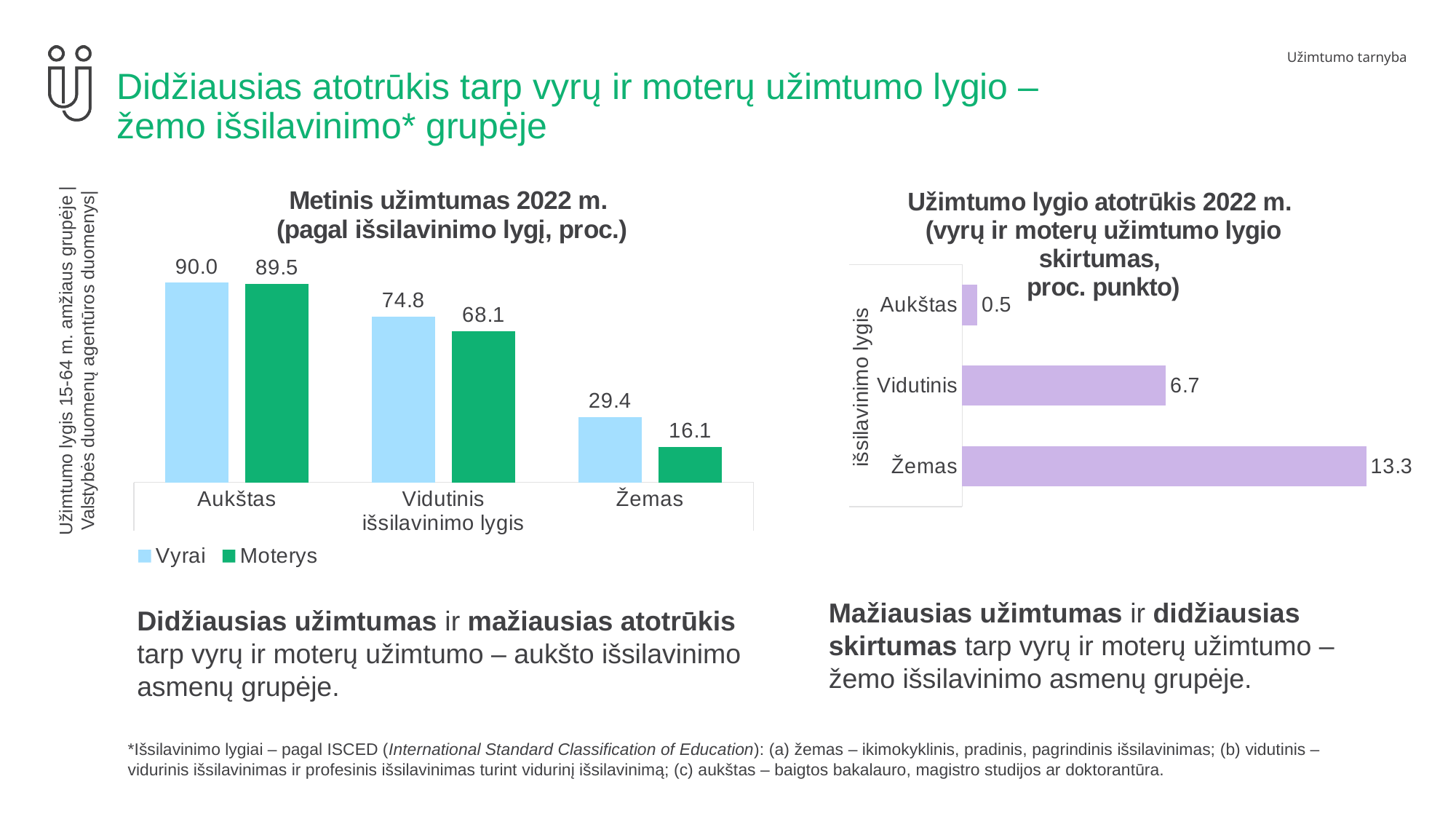
In the right chart (Užimtumo lygio atotrūkis 2022 m.), what is the value for Vidutinis? 6.7 In the right chart (Užimtumo lygio atotrūkis 2022 m.), which category has the highest value? Žemas In the left chart (Metinis užimtumas 2022 m.), what is the value for Moterys in the Žemas category? 16.1 In the left chart (Metinis užimtumas 2022 m.), what is the value for Moterys in the Vidutinis category? 68.1 In the left chart (Metinis užimtumas 2022 m.), which category has the lowest value for Vyrai? Žemas In the left chart (Metinis užimtumas 2022 m.), which is larger in the Žemas category, Vyrai or Moterys? Vyrai In the left chart (Metinis užimtumas 2022 m.), do the values for Moterys rise or fall from Aukštas to Žemas? fall In the right chart (Užimtumo lygio atotrūkis 2022 m.), what is the difference between Žemas and Aukštas? 12.8 In the left chart (Metinis užimtumas 2022 m.), what is the difference between Vyrai and Moterys in the Vidutinis category? 6.7 What kind of chart is the right chart (Užimtumo lygio atotrūkis 2022 m.)? bar chart How many series does the legend of the left chart (Metinis užimtumas 2022 m.) list? 2 In the left chart (Metinis užimtumas 2022 m.), what is the value for Vyrai in the Aukštas category? 90.0